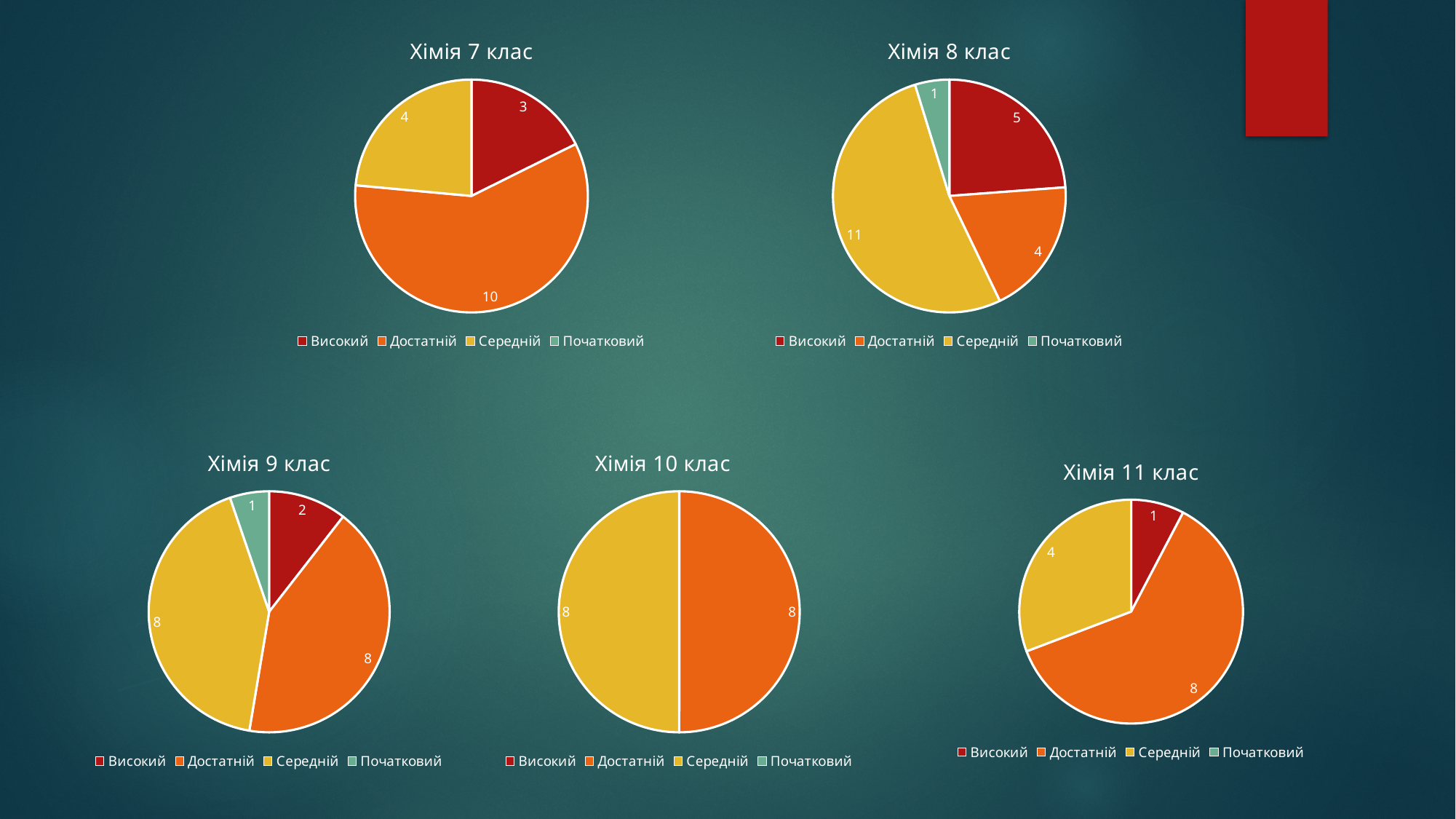
In the "Хімія 8 клас" chart, which is larger, Високий or Достатній? Високий In the "Хімія 8 клас" chart, what is the value for Середній? 11 What kind of chart is "Хімія 10 клас"? Pie chart In the "Хімія 7 клас" chart, what is the value for Достатній? 10 In the "Хімія 8 клас" chart, which category has the largest slice? Середній In the "Хімія 10 клас" chart, what share of the pie does Середній take? 50% In the "Хімія 9 клас" chart, what is the value for Початковий? 1 In the "Хімія 7 клас" chart, what is the difference between the Достатній and Середній values? 6 In the "Хімія 11 клас" chart, what is the value for Високий? 1 How many slices with data labels does the "Хімія 11 клас" chart show? 3 In the "Хімія 9 клас" chart, which category has the smallest slice? Початковий How many entries does the legend of the "Хімія 9 клас" chart list? 4